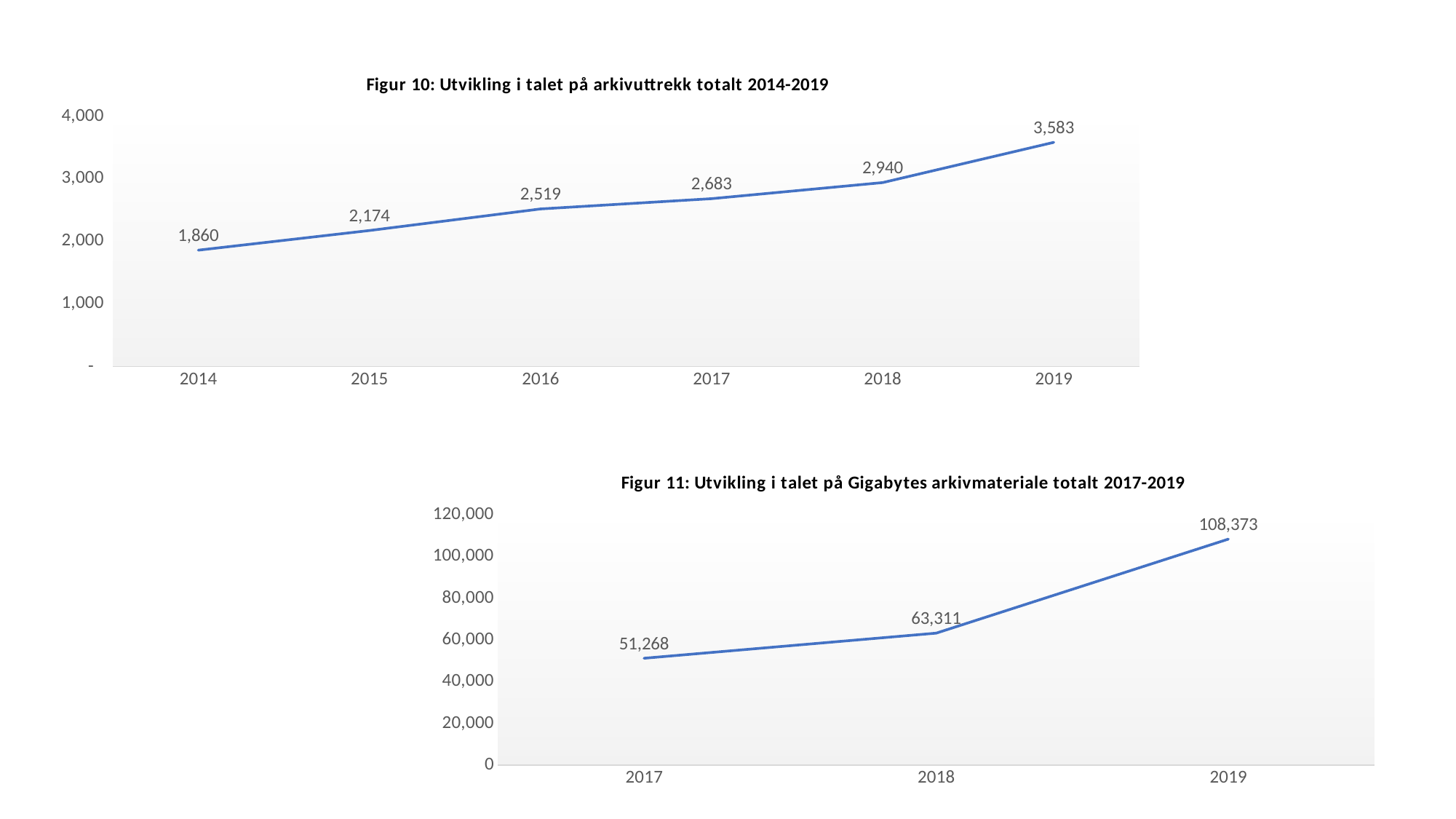
In the Figur 10 chart (top), what is the difference between the 2019 value and the 2018 value? 643 In the Figur 10 chart (top), what is the value for 2014? 1,860 In the Figur 11 chart (bottom), is the value for 2019 greater or less than 100,000? greater In the Figur 11 chart (bottom), what is the value for 2018? 63,311 In the Figur 10 chart (top), how many years are plotted? 6 In the Figur 10 chart (top), which year has the lowest value? 2014 In the Figur 10 chart (top), what is the value for 2016? 2,519 In the Figur 10 chart (top), which year has the highest value? 2019 In the Figur 10 chart (top), do the values rise or fall from 2014 to 2019? rise In the Figur 11 chart (bottom), how many years are plotted? 3 What kind of chart is the Figur 11 chart (bottom)? line chart In the Figur 11 chart (bottom), what is the difference between the 2019 value and the 2017 value? 57,105